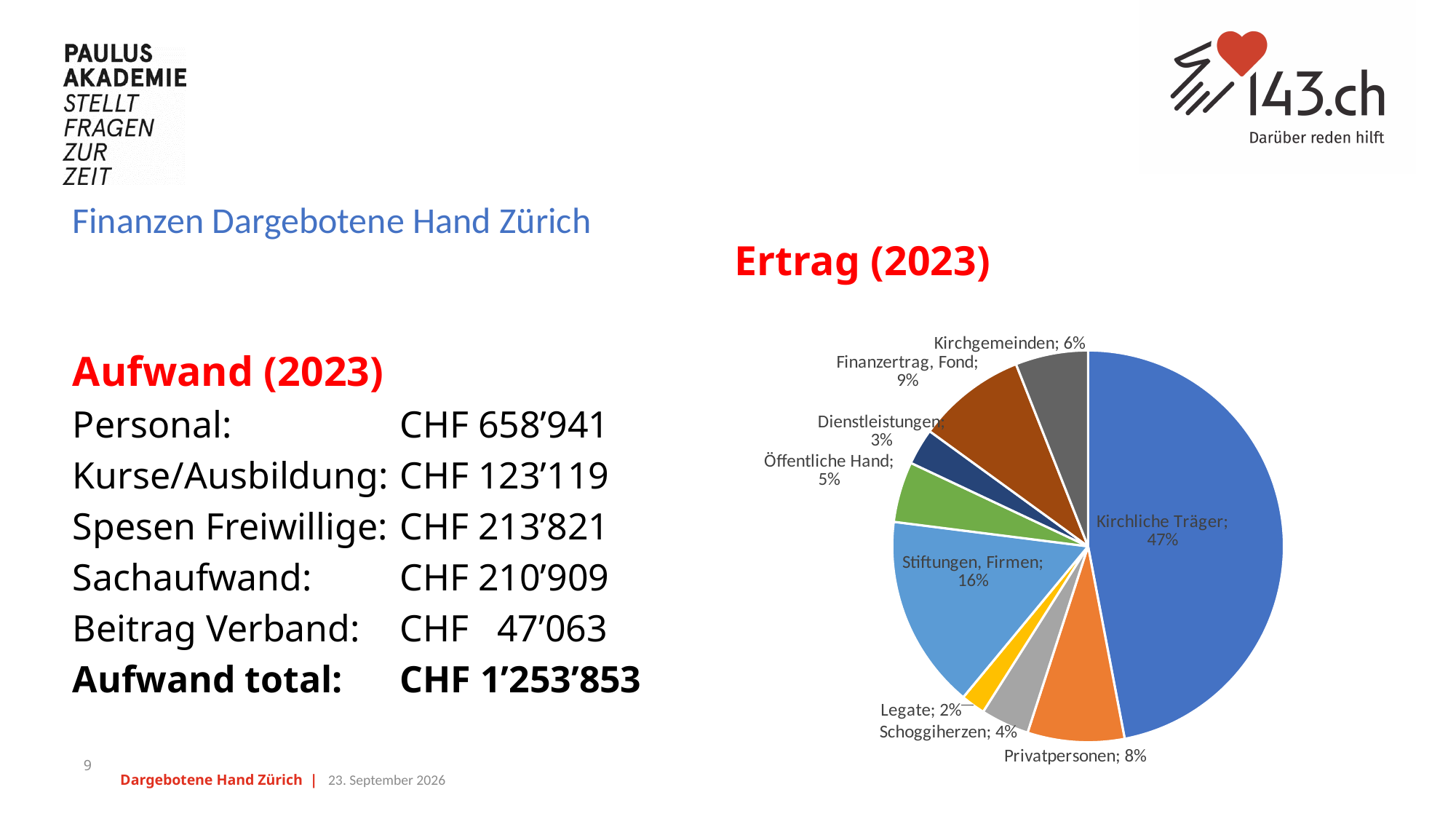
What is the value shown for Schoggiherzen? 4% What is the value shown for Stiftungen, Firmen? 16% Which category has the smallest slice of the pie? Legate What is the value shown for Privatpersonen? 8% What is the difference in percentage points between Kirchliche Träger and Stiftungen, Firmen? 31 How many slices does the pie chart have? 9 Which is larger, Kirchgemeinden or Öffentliche Hand? Kirchgemeinden What is the title of the chart? Ertrag (2023) What share of the pie does Kirchliche Träger have? 47% Which category has the largest slice of the pie? Kirchliche Träger What is the value shown for Finanzertrag, Fond? 9% What kind of chart is shown on the slide? pie chart